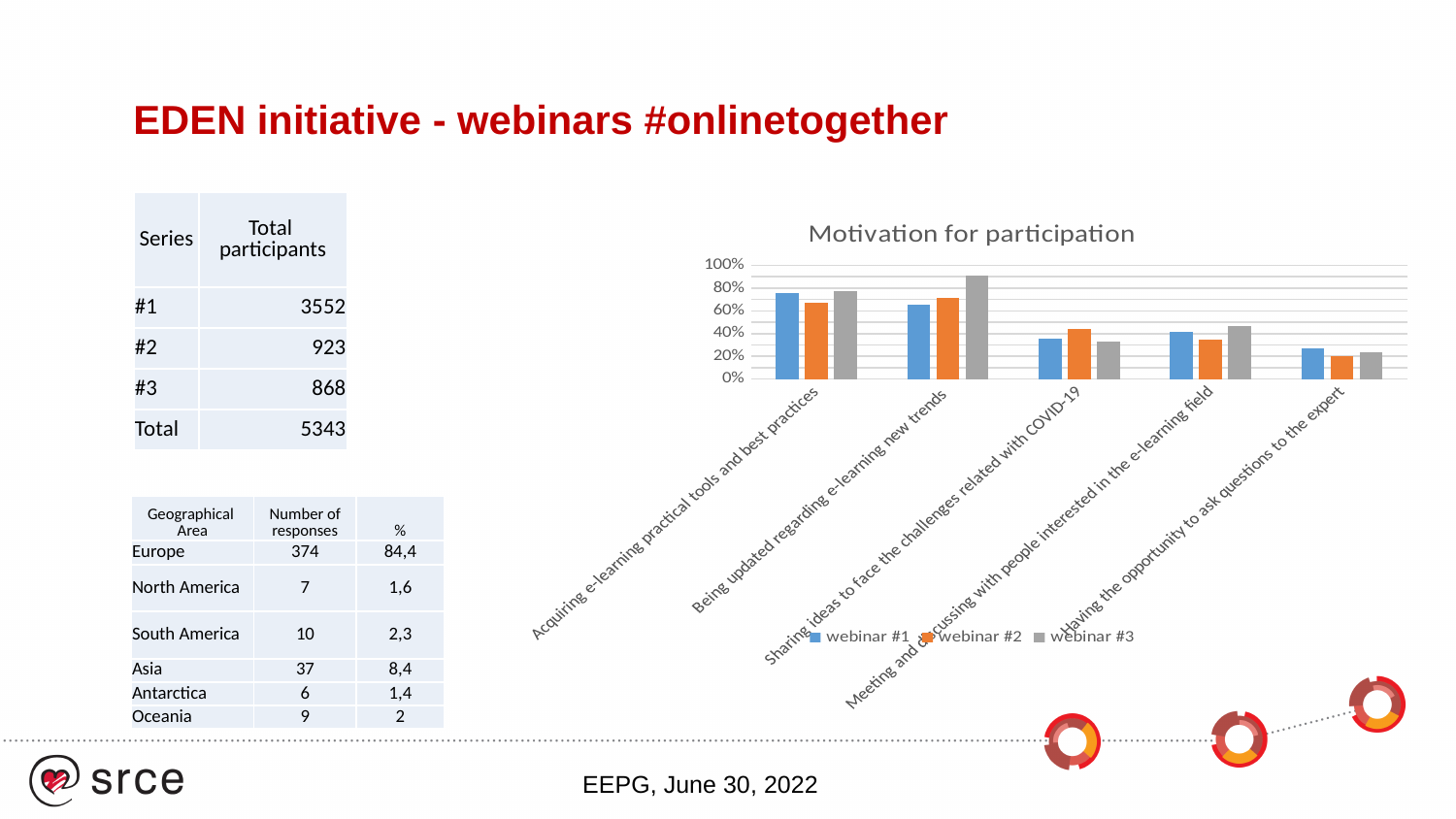
What is the title of the chart on the slide? Motivation for participation How many categories are shown on the x axis of the "Motivation for participation" chart? 5 What kind of chart is the "Motivation for participation" chart? bar chart In the "Motivation for participation" chart, which webinar has the highest value for "Being updated regarding e-learning new trends"? webinar #3 In the "Motivation for participation" chart, is the value for webinar #2 in "Having the opportunity to ask questions to the expert" greater or less than 40%? less In the "Motivation for participation" chart, for "Sharing ideas to face the challenges related with COVID-19", which is larger: webinar #2 or webinar #3? webinar #2 In the "Motivation for participation" chart, is the value for webinar #1 in "Acquiring e-learning practical tools and best practices" greater or less than 60%? greater How many series does the legend of the "Motivation for participation" chart list? 3 In the "Motivation for participation" chart, is the value for webinar #3 in "Being updated regarding e-learning new trends" greater or less than 80%? greater In the "Motivation for participation" chart, which category has the lowest values across all three webinars? Having the opportunity to ask questions to the expert Which series is shown in orange in the "Motivation for participation" chart? webinar #2